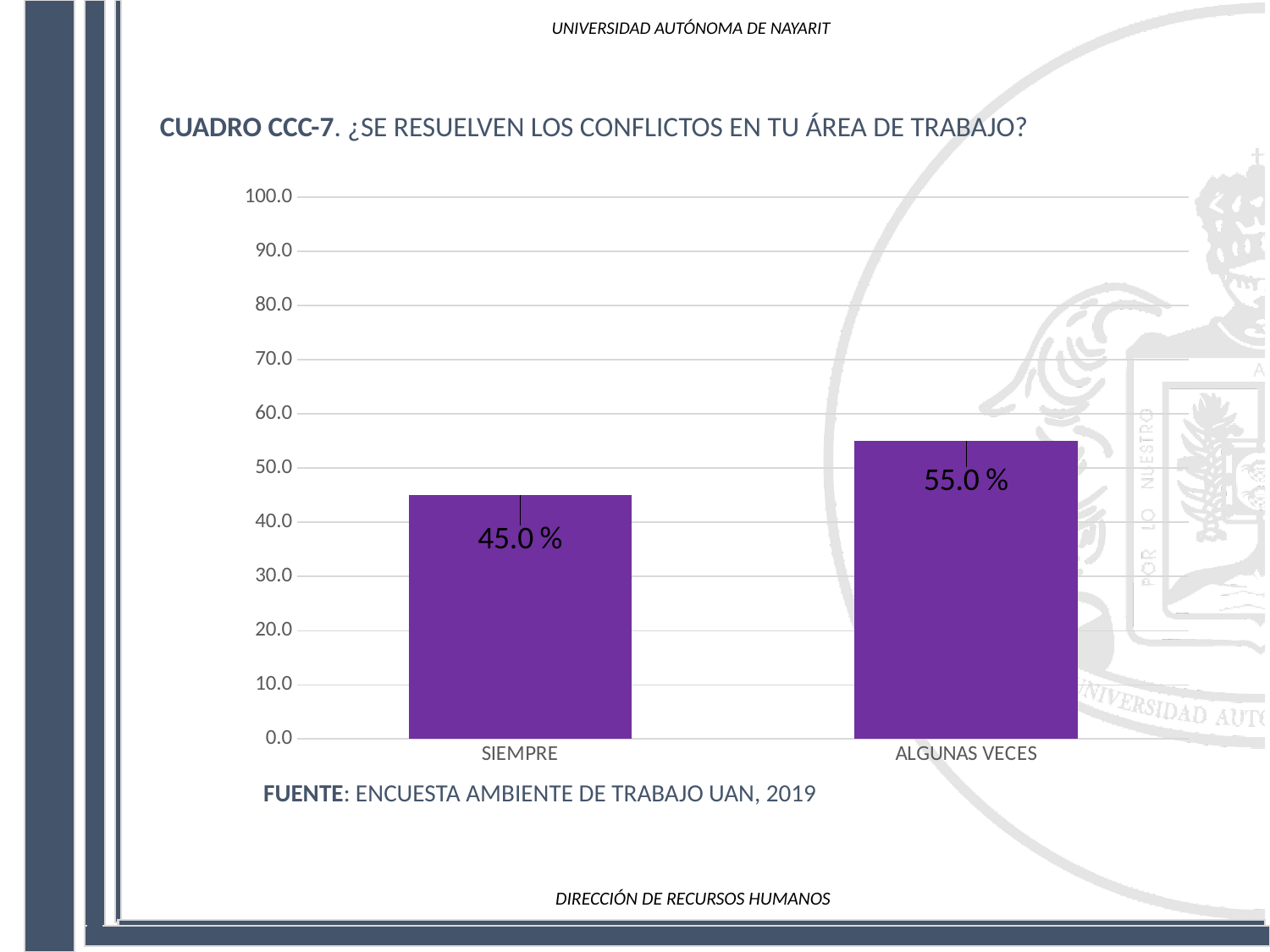
What is the value for ALGUNAS VECES? 55.0 % Is the value for SIEMPRE greater or less than 50.0? less What kind of chart is shown on the slide? bar chart Is the value for ALGUNAS VECES greater or less than 50.0? greater Which category has the lowest value? SIEMPRE Which category has the highest value? ALGUNAS VECES How many categories are shown on the x axis? 2 What source is cited below the chart? ENCUESTA AMBIENTE DE TRABAJO UAN, 2019 Which is larger, the value for SIEMPRE or the value for ALGUNAS VECES? ALGUNAS VECES What is the total of the two values shown in the chart? 100.0 % What is the difference between the values for ALGUNAS VECES and SIEMPRE? 10.0 % What is the value for SIEMPRE? 45.0 %